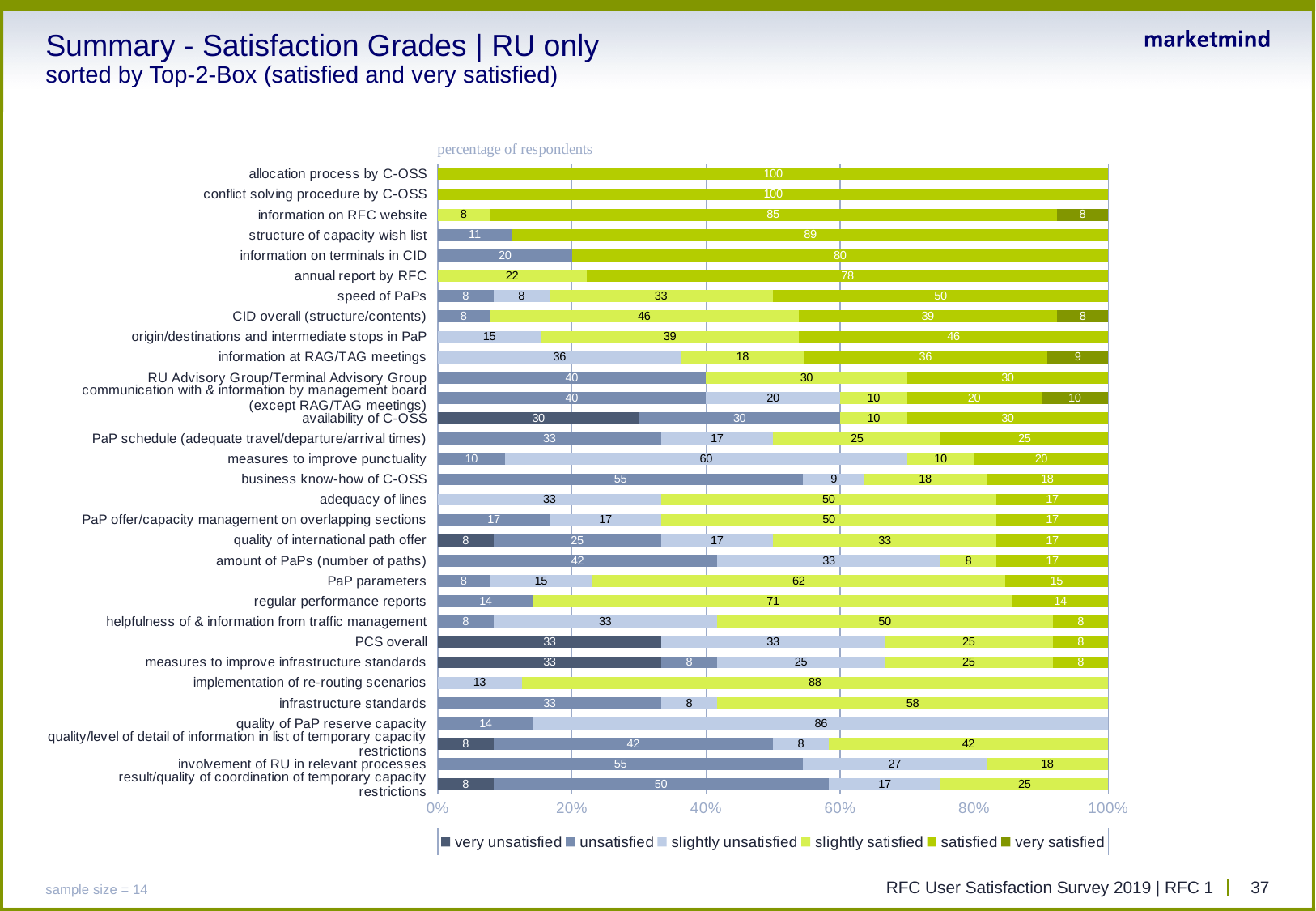
What is the total of the 'unsatisfied' and 'slightly unsatisfied' segments for 'involvement of RU in relevant processes'? 82 What kind of chart is shown on the slide? stacked bar chart What is the label on the x axis of the chart? percentage of respondents What is the 'satisfied' value for 'information on RFC website'? 85 What is the 'slightly satisfied' value for 'regular performance reports'? 71 Which is larger: the 'unsatisfied' value for 'business know-how of C-OSS' or the 'unsatisfied' value for 'amount of PaPs (number of paths)'? business know-how of C-OSS What is the difference between the 'satisfied' values for 'structure of capacity wish list' and 'information on terminals in CID'? 9 Which category has the highest 'slightly unsatisfied' value? quality of PaP reserve capacity What is the 'slightly unsatisfied' value for 'measures to improve punctuality'? 60 How many series does the legend list? 6 How many categories are plotted on the chart? 31 What is the 'very unsatisfied' value for 'PCS overall'? 33